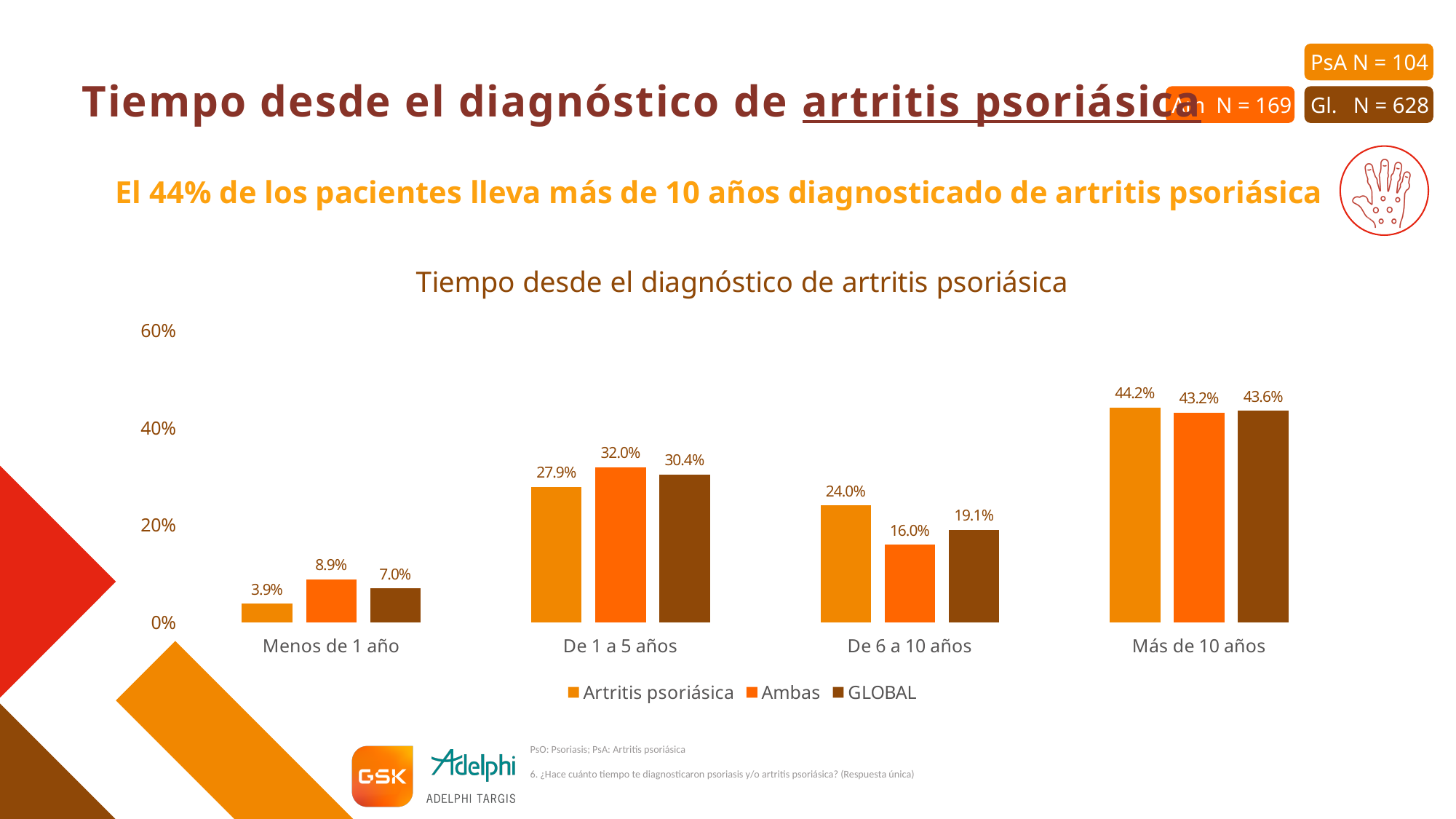
In the 'De 1 a 5 años' category, which is larger: Artritis psoriásica or GLOBAL? GLOBAL Is the GLOBAL value for 'De 6 a 10 años' greater or less than 20%? less What is the title of the chart? Tiempo desde el diagnóstico de artritis psoriásica How many series does the legend list? 3 What is the value for Artritis psoriásica in the 'Más de 10 años' category? 44.2% What is the value for Ambas in the 'De 1 a 5 años' category? 32.0% What is the difference between the Artritis psoriásica and Ambas values in the 'De 6 a 10 años' category? 8.0% What is the GLOBAL value for 'Menos de 1 año'? 7.0% What kind of chart is shown on the slide? Bar chart Which category has the lowest value for Ambas? Menos de 1 año How many categories are shown on the x axis? 4 Which category has the highest GLOBAL value? Más de 10 años